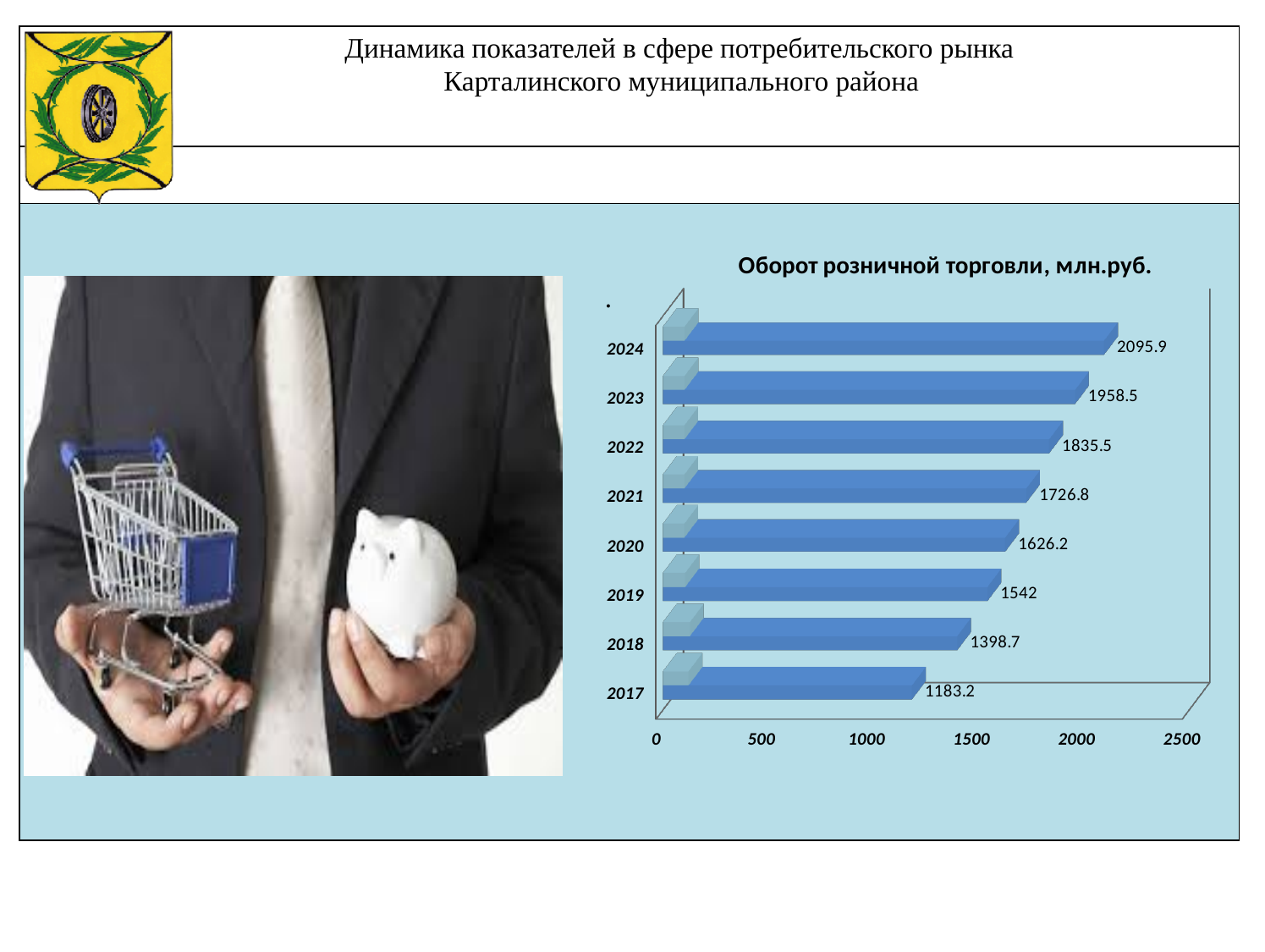
What is the difference between the values for 2024 and 2023? 137.4 What is the value shown for 2021? 1726.8 How many years are shown in the chart? 8 Which year has the highest retail trade turnover? 2024 Which year has the lowest retail trade turnover? 2017 What is the retail trade turnover value for 2024? 2095.9 What is the value shown for 2017? 1183.2 What is the title of the chart? Оборот розничной торговли, млн.руб. What is the value shown for 2019? 1542 What is the difference between the values for 2018 and 2017? 215.5 Which is larger, the value for 2020 or the value for 2022? 2022 What kind of chart is shown on the slide? Bar chart